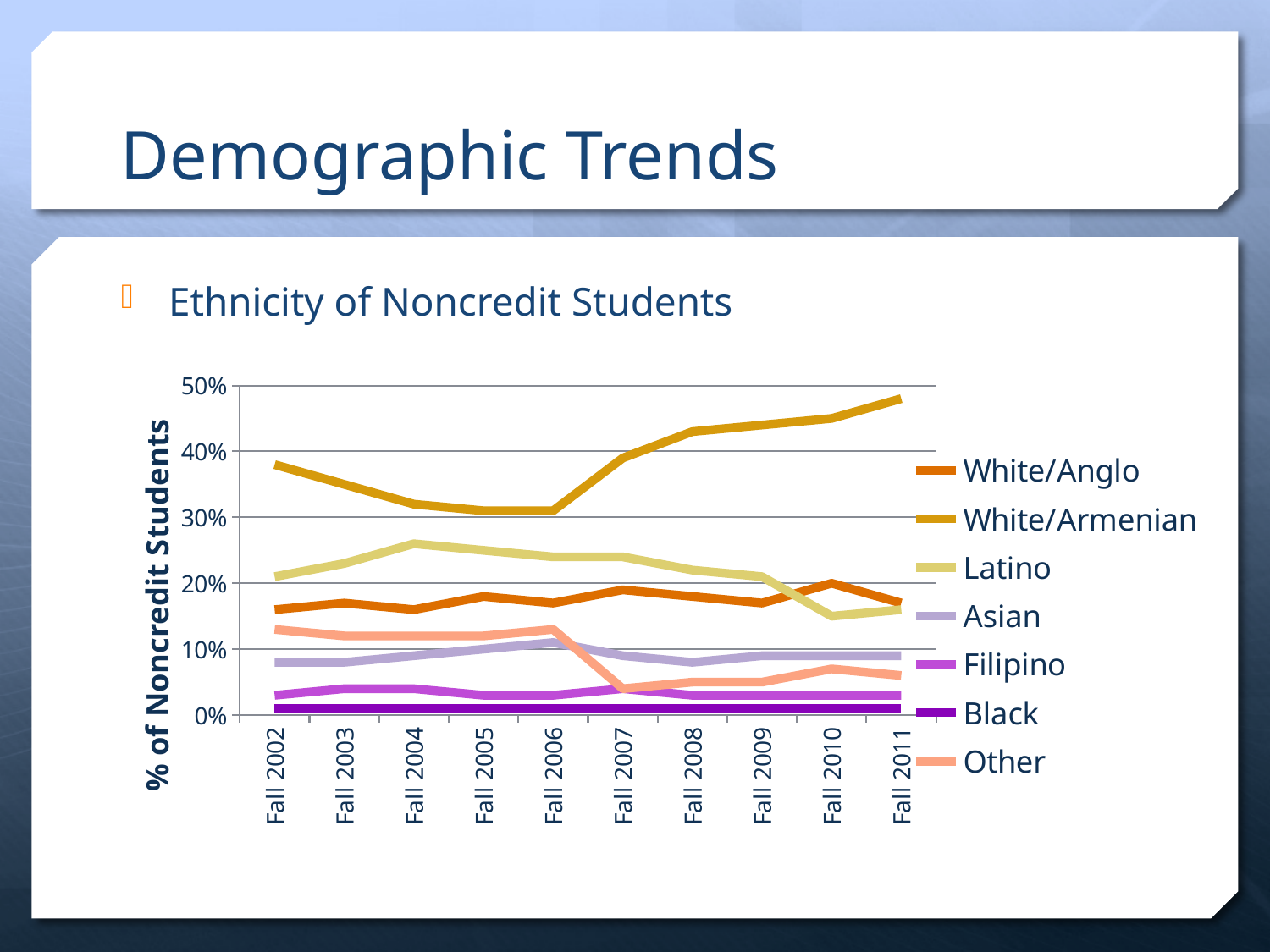
In Fall 2004, which is larger: Latino or White/Anglo? Latino Which ethnicity has the lowest share of noncredit students across the chart? Black How many series does the legend list? 7 Is the value for White/Armenian in Fall 2005 greater or less than 40%? less Is the value for Other in Fall 2002 greater or less than 10%? greater Does the White/Armenian share rise or fall from Fall 2006 to Fall 2011? rise How many Fall terms are plotted along the x axis? 10 What kind of chart is shown on the slide? line chart Is the value for White/Armenian in Fall 2011 greater or less than 40%? greater In Fall 2010, which is larger: White/Anglo or Latino? White/Anglo Which ethnicity has the highest share of noncredit students in Fall 2011? White/Armenian What is the title of the y axis? % of Noncredit Students